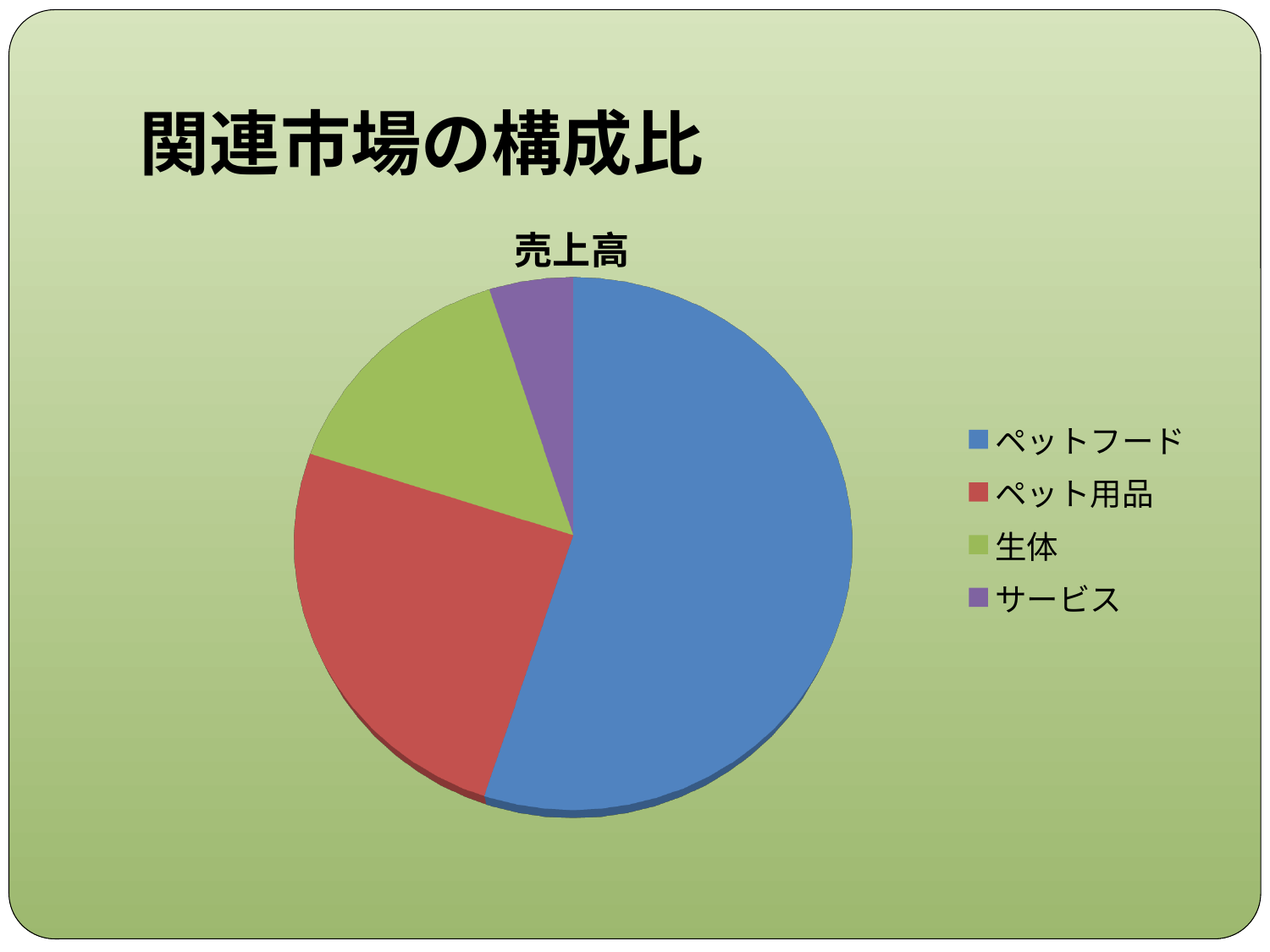
Which colour represents ペット用品 in the pie chart? red Which slice is larger, ペットフード or ペット用品? ペットフード How many categories does the pie chart have? 4 What kind of chart is shown on the slide? pie chart Which category is shown in blue? ペットフード Which category has the smallest slice of the pie? サービス Which slice is larger, 生体 or サービス? 生体 What is the title of the chart? 売上高 Which category has the largest slice of the pie? ペットフード Which slice is larger, ペット用品 or 生体? ペット用品 How many entries does the legend list? 4